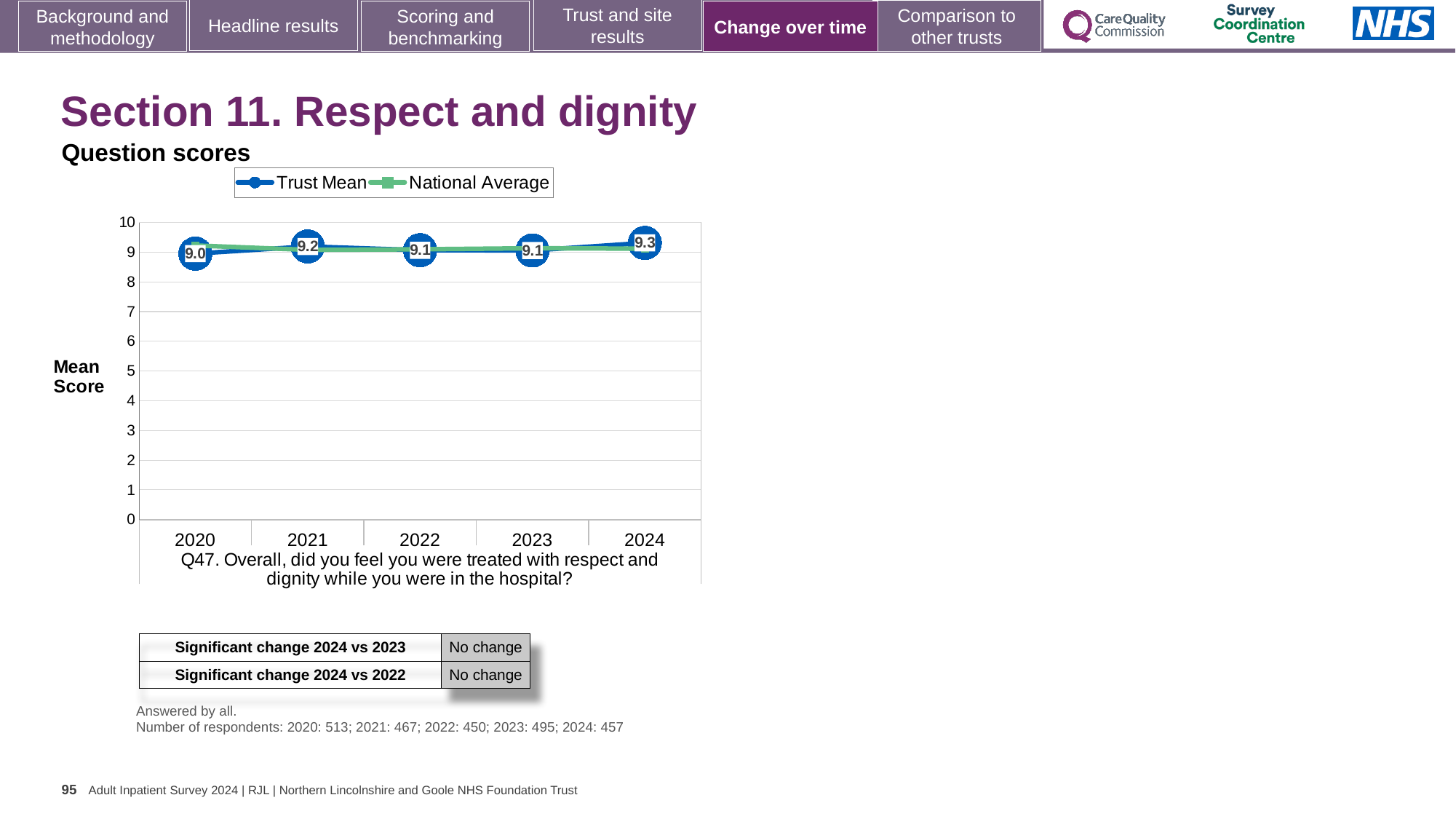
How many years are plotted on the x axis? 5 Which question does the chart show scores for? Q47. Overall, did you feel you were treated with respect and dignity while you were in the hospital? What is the Trust Mean score for 2024? 9.3 Which year has the larger Trust Mean score, 2020 or 2021? 2021 What is the Trust Mean score for 2021? 9.2 What is the Trust Mean score for 2020? 9.0 In which year is the Trust Mean score lowest? 2020 Is the National Average value for 2020 greater or less than 8? greater What kind of chart is shown? line chart How many series does the legend list? 2 In which year is the Trust Mean score highest? 2024 What is the difference between the Trust Mean score in 2024 and in 2020? 0.3